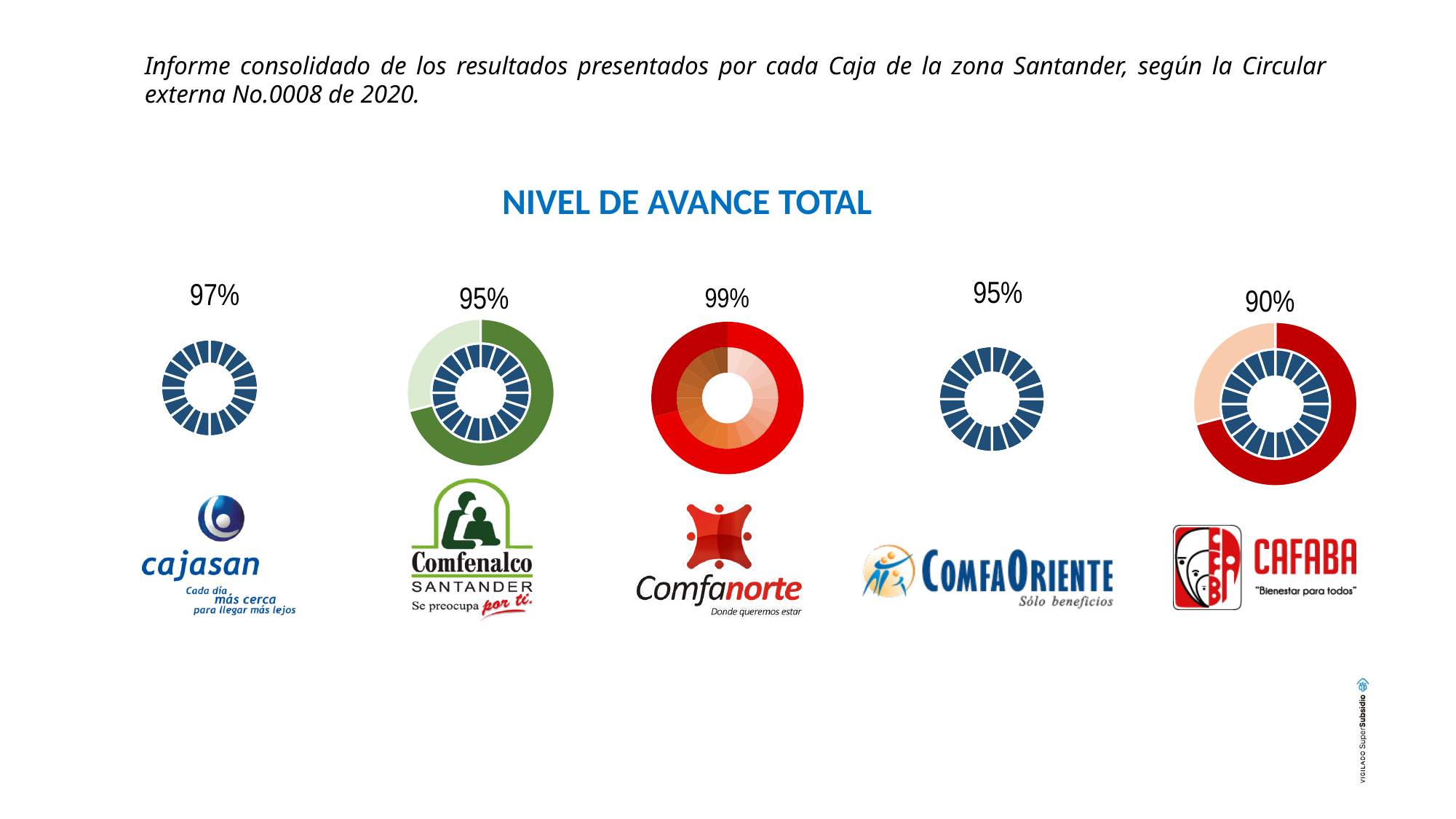
What is the value shown above the Comfenalco Santander chart? 95% What is the value shown above the Comfanorte chart? 99% What is the value shown above the ComfaOriente chart? 95% What is the difference between the Cajasan value and the Comfenalco Santander value? 2 percentage points What is the title shown above the charts? NIVEL DE AVANCE TOTAL What is the value shown above the Cajasan chart? 97% What is the difference between the Comfanorte value and the Cafaba value? 9 percentage points Which Caja has the lowest nivel de avance total on the slide? Cafaba What is the value shown above the Cafaba chart? 90% Which is larger, the Cajasan value or the Cafaba value? Cajasan How many Cajas have a chart on the slide? 5 Which Caja has the highest nivel de avance total on the slide? Comfanorte